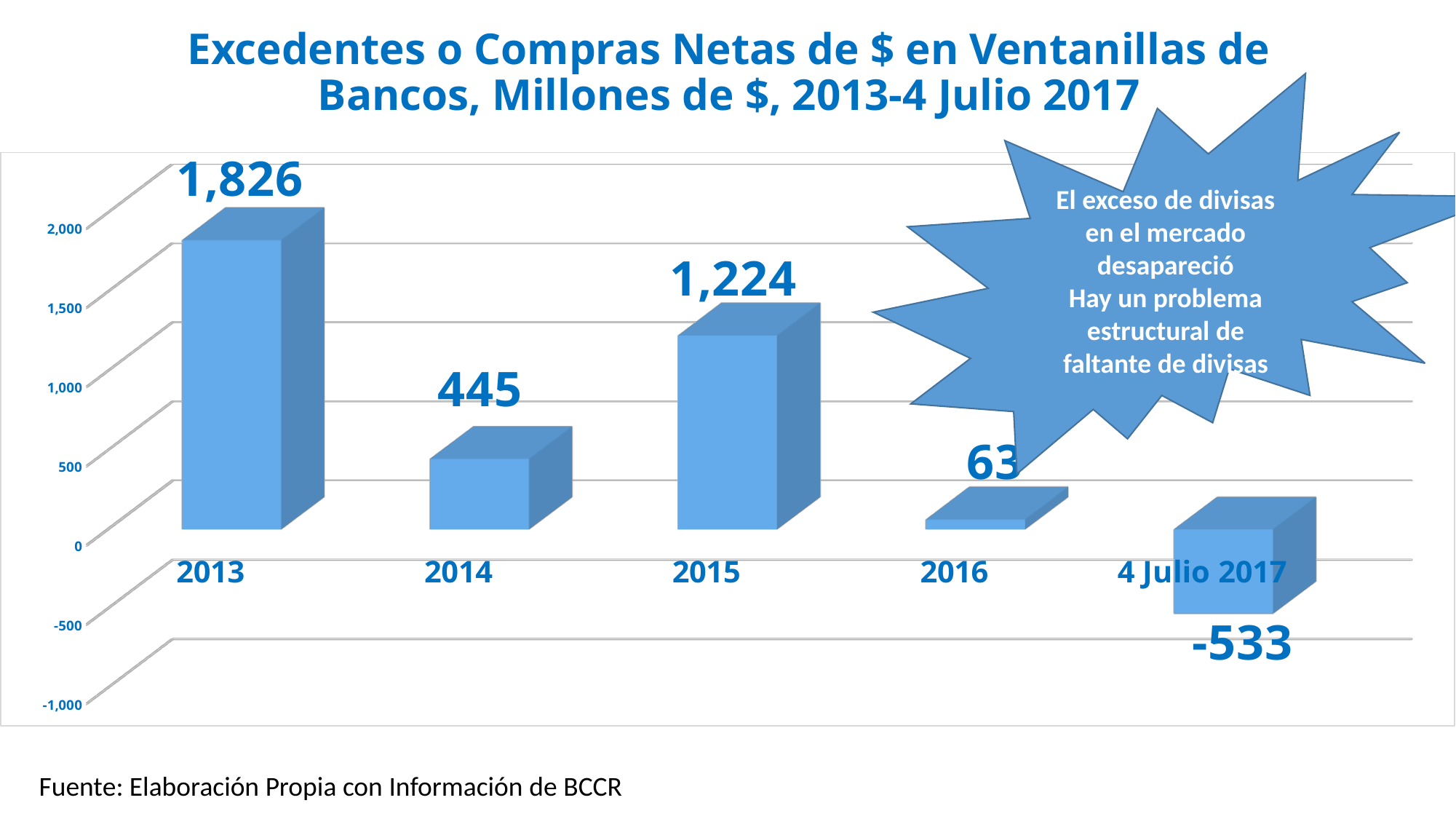
What is the value for 2013? 1,826 What is the value for 2015? 1,224 Which category has the lowest value? 4 Julio 2017 What is the source cited below the chart? Elaboración Propia con Información de BCCR How many categories are shown on the x axis? 5 What is the difference between the values for 2013 and 2015? 602 Which category has the highest value? 2013 What is the value for 2014? 445 What is the value for 2016? 63 Which is larger, the value for 2014 or the value for 2016? 2014 What kind of chart is shown on the slide? Bar chart What is the value for 4 Julio 2017? -533